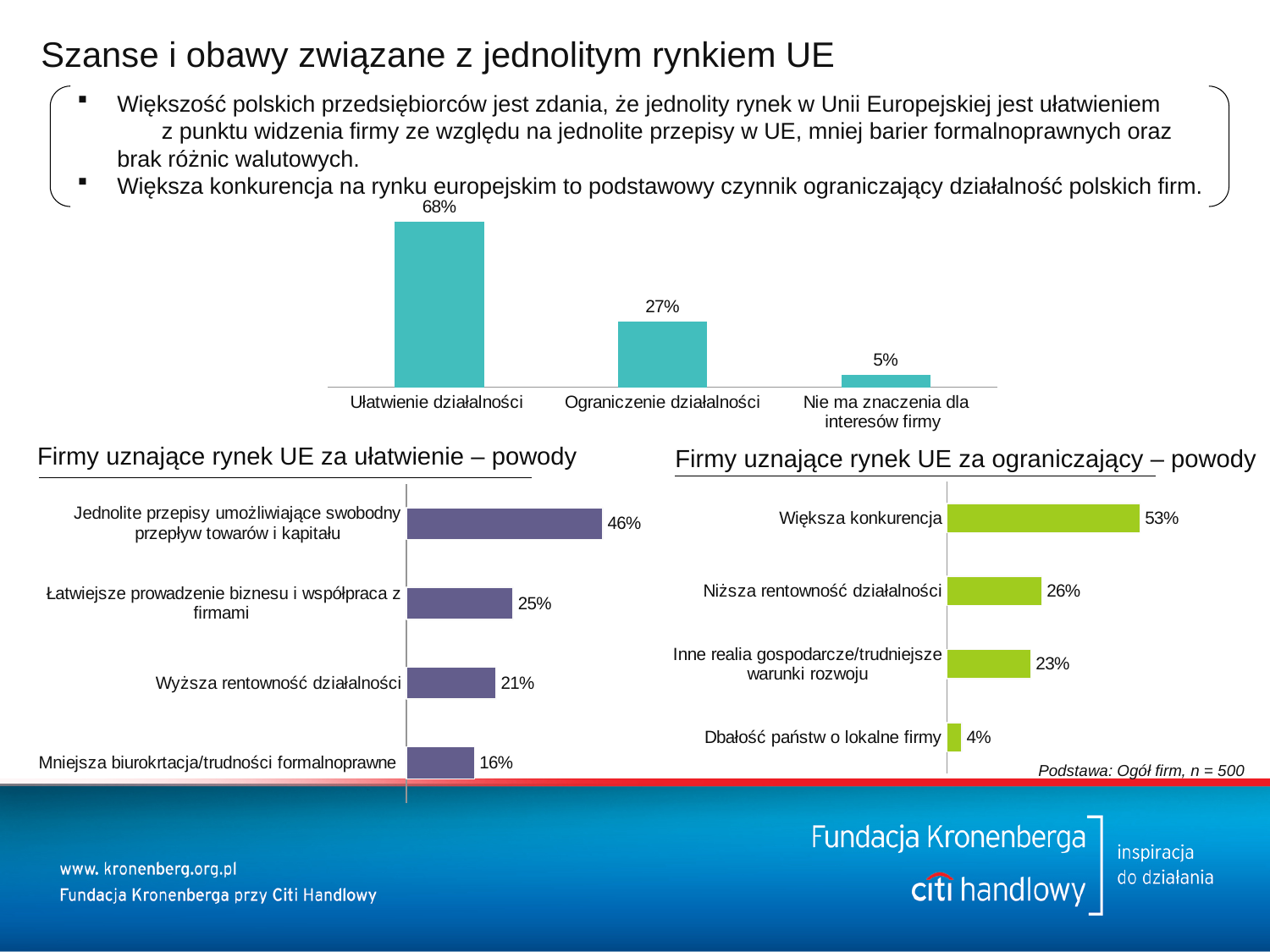
In the chart "Firmy uznające rynek UE za ograniczający – powody", which is larger: "Niższa rentowność działalności" or "Inne realia gospodarcze/trudniejsze warunki rozwoju"? Niższa rentowność działalności In the chart "Firmy uznające rynek UE za ograniczający – powody", which reason has the lowest value? Dbałość państw o lokalne firmy In the top chart, which category has the lowest value? Nie ma znaczenia dla interesów firmy In the chart "Firmy uznające rynek UE za ułatwienie – powody", what is the difference between "Łatwiejsze prowadzenie biznesu i współpraca z firmami" and "Mniejsza biurokrtacja/trudności formalnoprawne"? 9 percentage points In the top chart, what is the value for "Ułatwienie działalności"? 68% In the chart "Firmy uznające rynek UE za ograniczający – powody", what is the value for "Większa konkurencja"? 53% How many reasons are listed in the chart "Firmy uznające rynek UE za ograniczający – powody"? 4 In the chart "Firmy uznające rynek UE za ułatwienie – powody", what is the value for "Wyższa rentowność działalności"? 21% How many categories does the top chart show? 3 In the chart "Firmy uznające rynek UE za ułatwienie – powody", which reason has the highest value? Jednolite przepisy umożliwiające swobodny przepływ towarów i kapitału In the top chart, what is the difference between "Ułatwienie działalności" and "Ograniczenie działalności"? 41 percentage points What kind of chart is "Firmy uznające rynek UE za ułatwienie – powody"? Bar chart